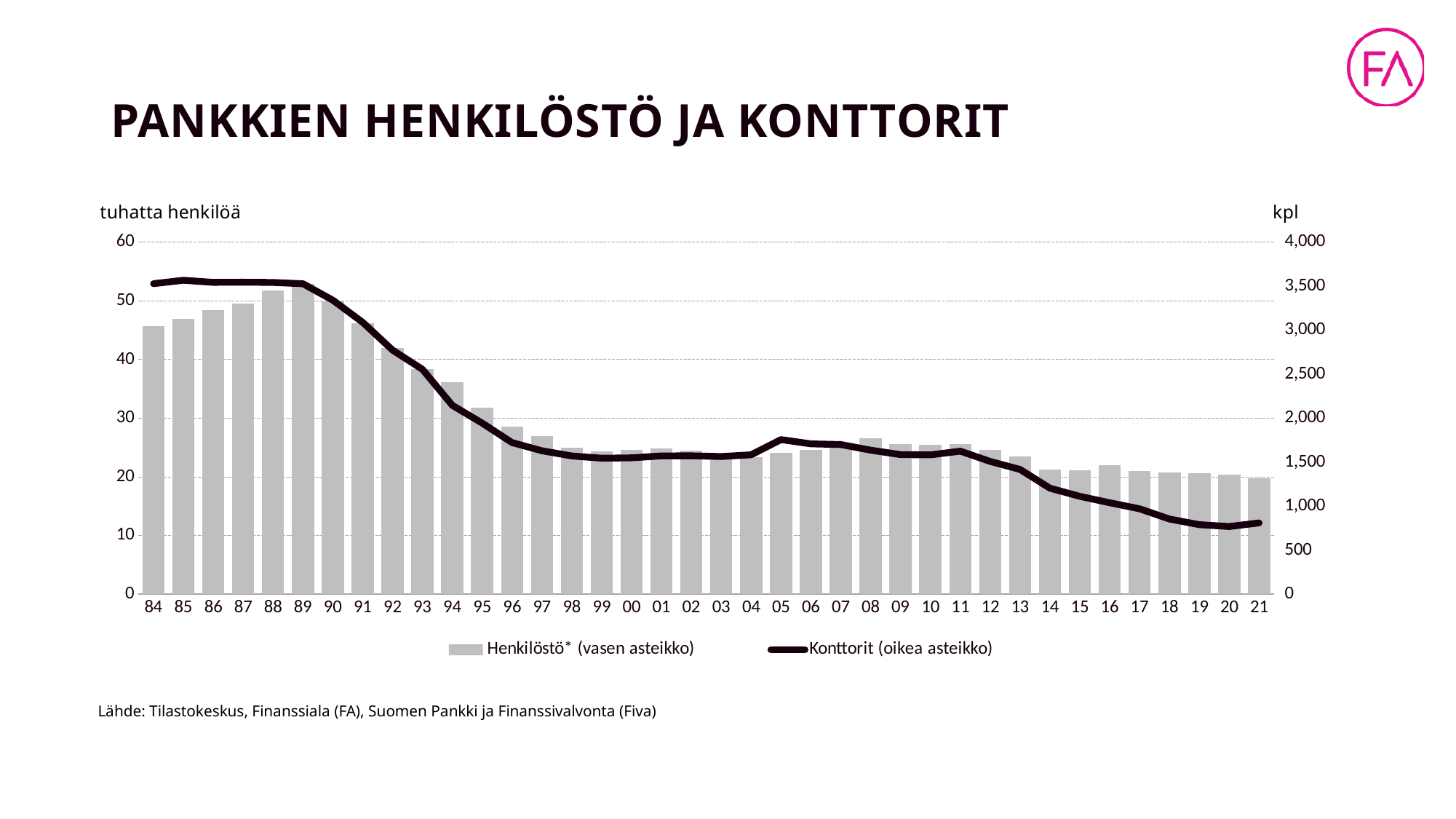
What is the title of the chart? PANKKIEN HENKILÖSTÖ JA KONTTORIT Is the Konttorit value for 05 greater or less than 1,500? greater What unit label is shown above the left axis? tuhatta henkilöä Is the Henkilöstö bar for 99 greater or less than 30? less Do the Henkilöstö bars rise or fall from 89 to 21? fall Is the Konttorit value for 21 greater or less than 1,000? less What kind of chart is shown on the slide? A combined bar and line chart How many years are shown on the x axis? 38 Which is larger, the Henkilöstö bar for 90 or for 95? 90 How many series does the legend list? 2 Which is larger, the Konttorit value for 89 or for 94? 89